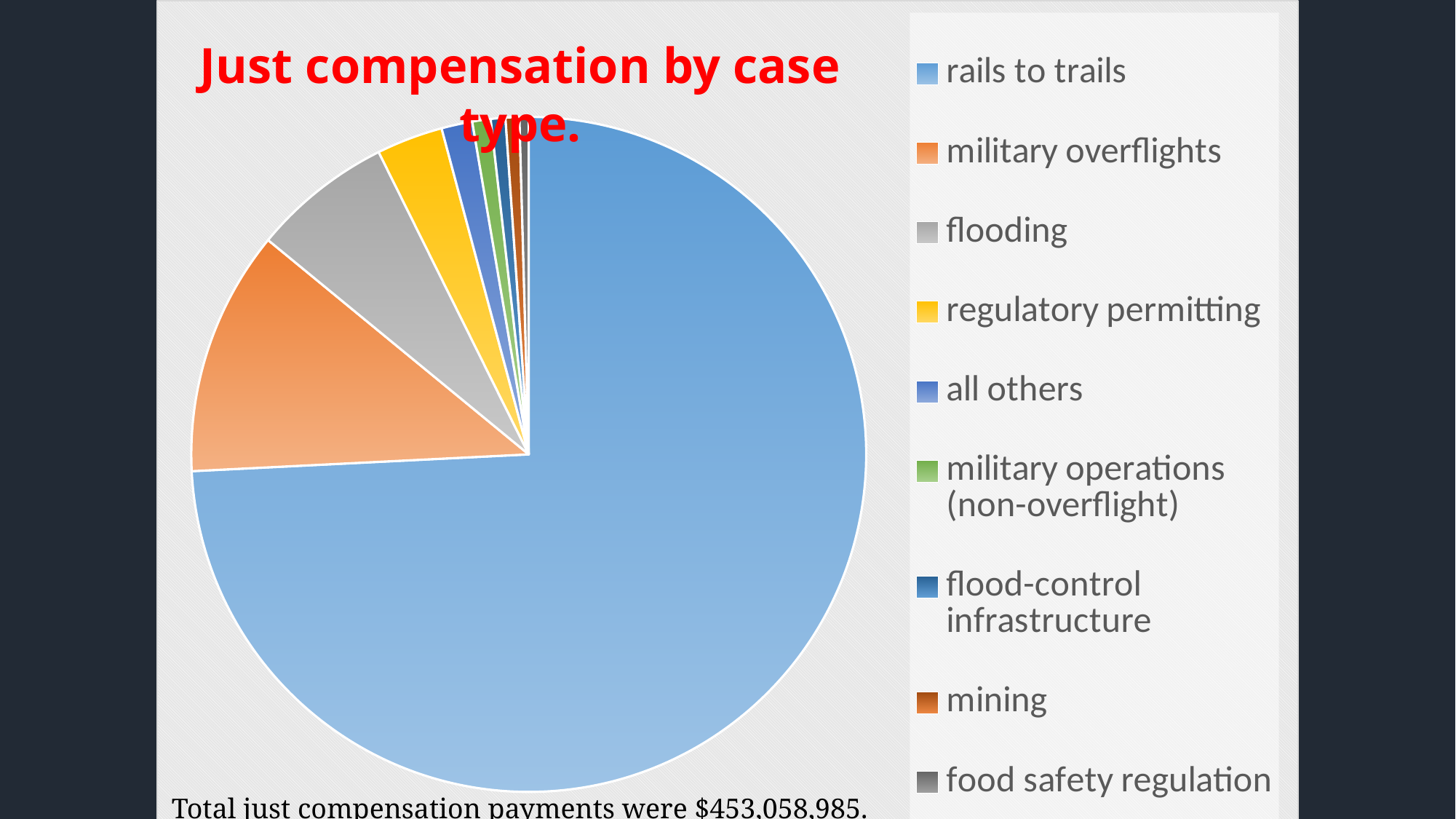
Which case type accounts for the largest share of just compensation in the pie chart? rails to trails Is the rails to trails slice larger or smaller than all the other slices combined? larger What kind of chart is shown on the slide? pie chart What is the title of the chart on the slide? Just compensation by case type. What colour is the slice for rails to trails in the pie chart? blue How many case types (categories) does the pie chart's legend list? 9 Which is larger in the pie chart: the slice for regulatory permitting or the slice for all others? regulatory permitting Which case type is the second-largest slice in the pie chart? military overflights Which is larger in the pie chart: the slice for rails to trails or the slice for military overflights? rails to trails According to the text below the chart, what were the total just compensation payments? $453,058,985